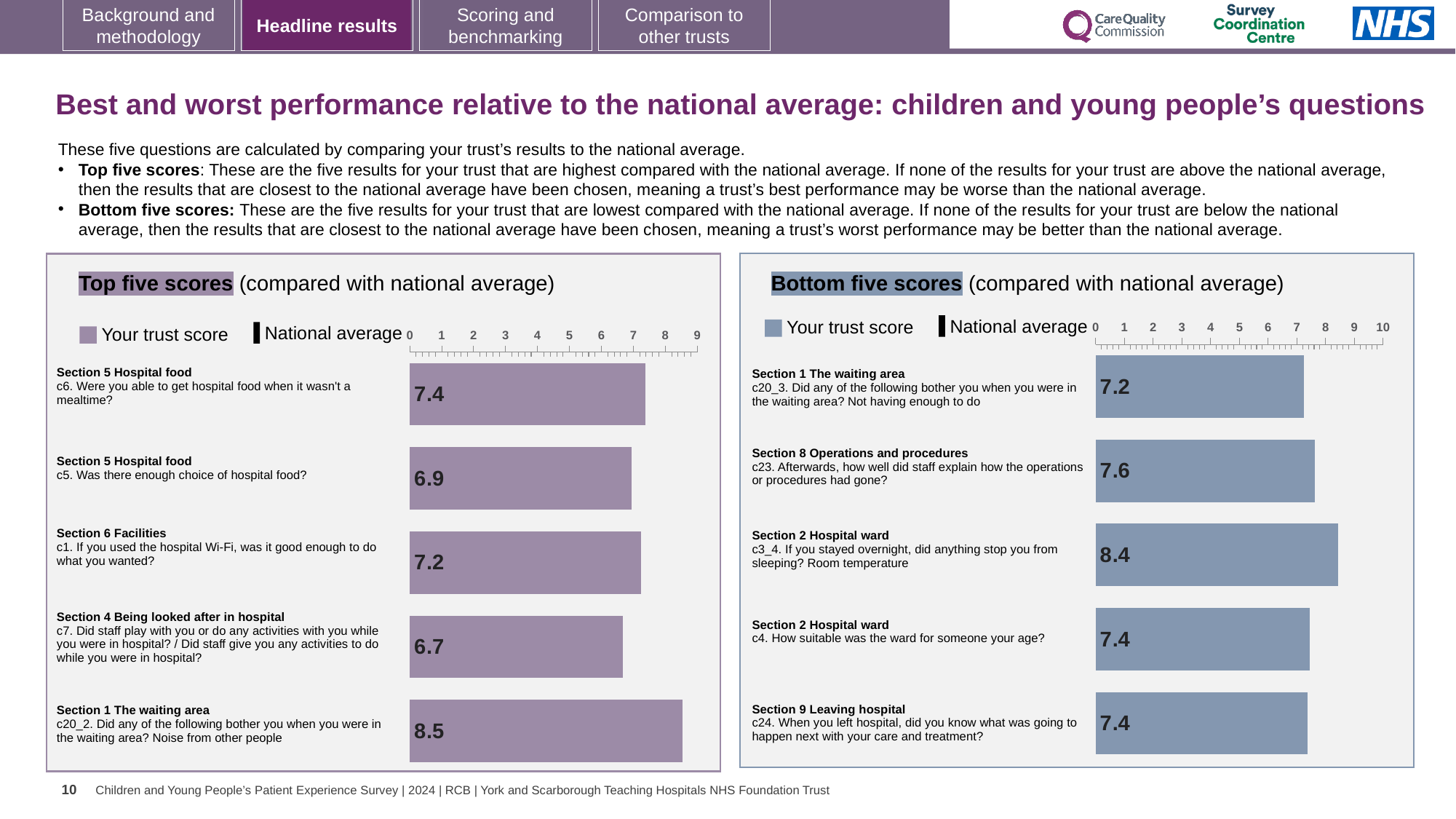
In the Top five scores chart, which question has the lowest trust score? c7. Did staff play with you or do any activities with you while you were in hospital? In the Top five scores chart, what is the trust score for c6 (Were you able to get hospital food when it wasn't a mealtime?)? 7.4 In the Bottom five scores chart, which is larger: the trust score for c23 (explaining operations or procedures) or for c4 (How suitable was the ward for someone your age?)? c23 In the Bottom five scores chart, what is the trust score for c20_3 (Not having enough to do in the waiting area)? 7.2 In the Bottom five scores chart, what is the difference between the trust scores for c3_4 (Room temperature) and c20_3 (Not having enough to do)? 1.2 How many questions are plotted in the Top five scores chart? 5 In the Bottom five scores chart, what is the trust score for c23 (Afterwards, how well did staff explain how the operations or procedures had gone?)? 7.6 What type of chart is used in the Bottom five scores panel? Bar chart In the Top five scores chart, what is the trust score for c7 (Did staff play with you or do any activities with you while you were in hospital?)? 6.7 In the Top five scores chart, which question has the highest trust score? c20_2. Did any of the following bother you when you were in the waiting area? Noise from other people In the Bottom five scores chart, which question has the highest trust score? c3_4. If you stayed overnight, did anything stop you from sleeping? Room temperature In the Top five scores chart, what is the difference between the trust scores for c20_2 (Noise from other people) and c5 (Was there enough choice of hospital food?)? 1.6